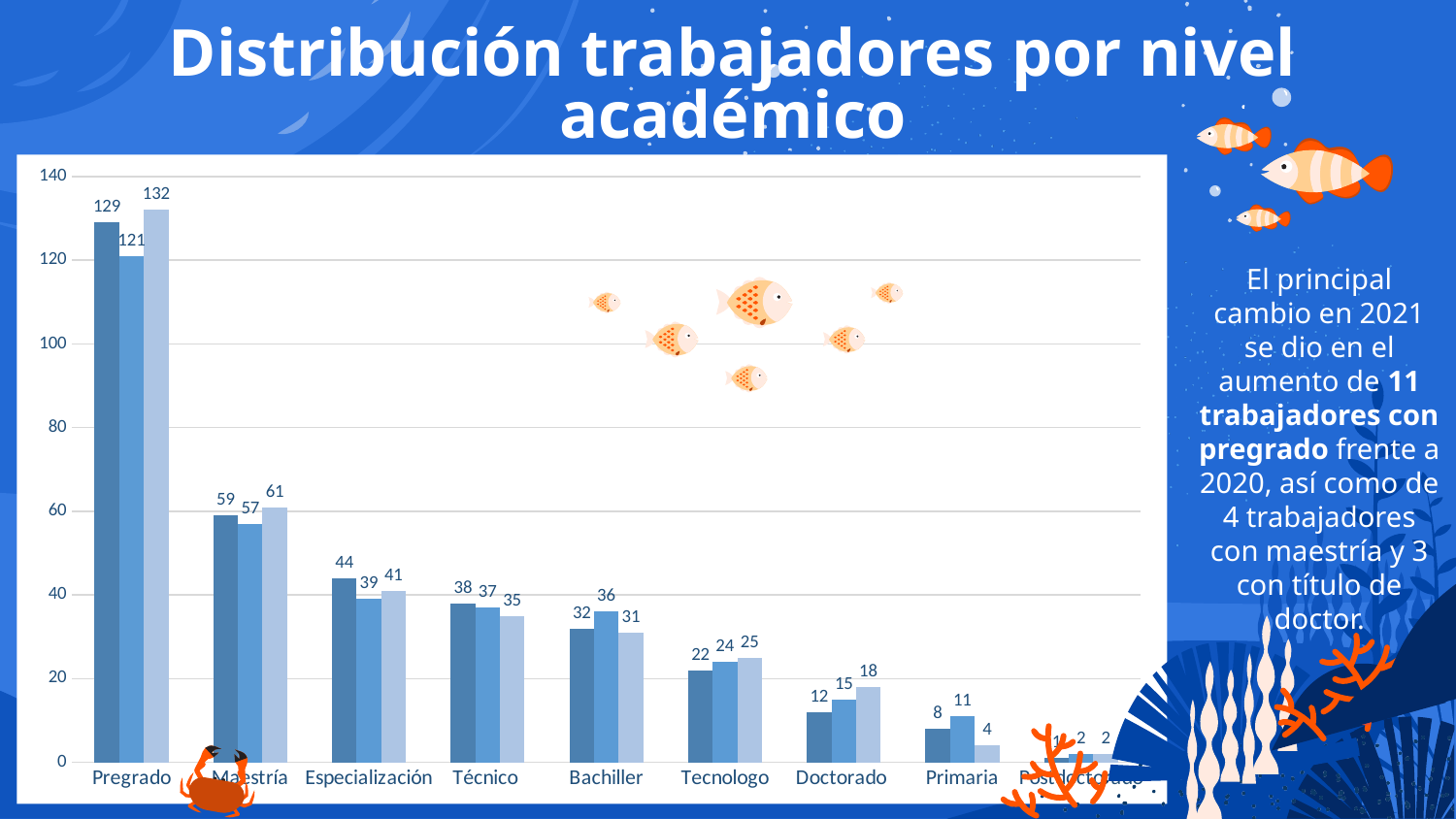
What type of chart is shown on the slide? bar chart What is the value of the third (lightest blue) bar for Doctorado? 18 What is the value of the third (lightest blue) bar for Primaria? 4 Is the value of the first (darkest blue) bar for Técnico greater or less than 40? less Which category has the highest values in the chart? Pregrado What is the value of the first (darkest blue) bar for Pregrado? 129 What is the title of the chart on the slide? Distribución trabajadores por nivel académico How many bars are shown for each category? 3 Which is larger for Especialización: the first (darkest blue) bar or the second (medium blue) bar? the first (darkest blue) bar What is the value of the third (lightest blue) bar for Maestría? 61 What is the difference between the third (lightest blue) bar and the second (medium blue) bar for Pregrado? 11 What is the value of the second (medium blue) bar for Bachiller? 36